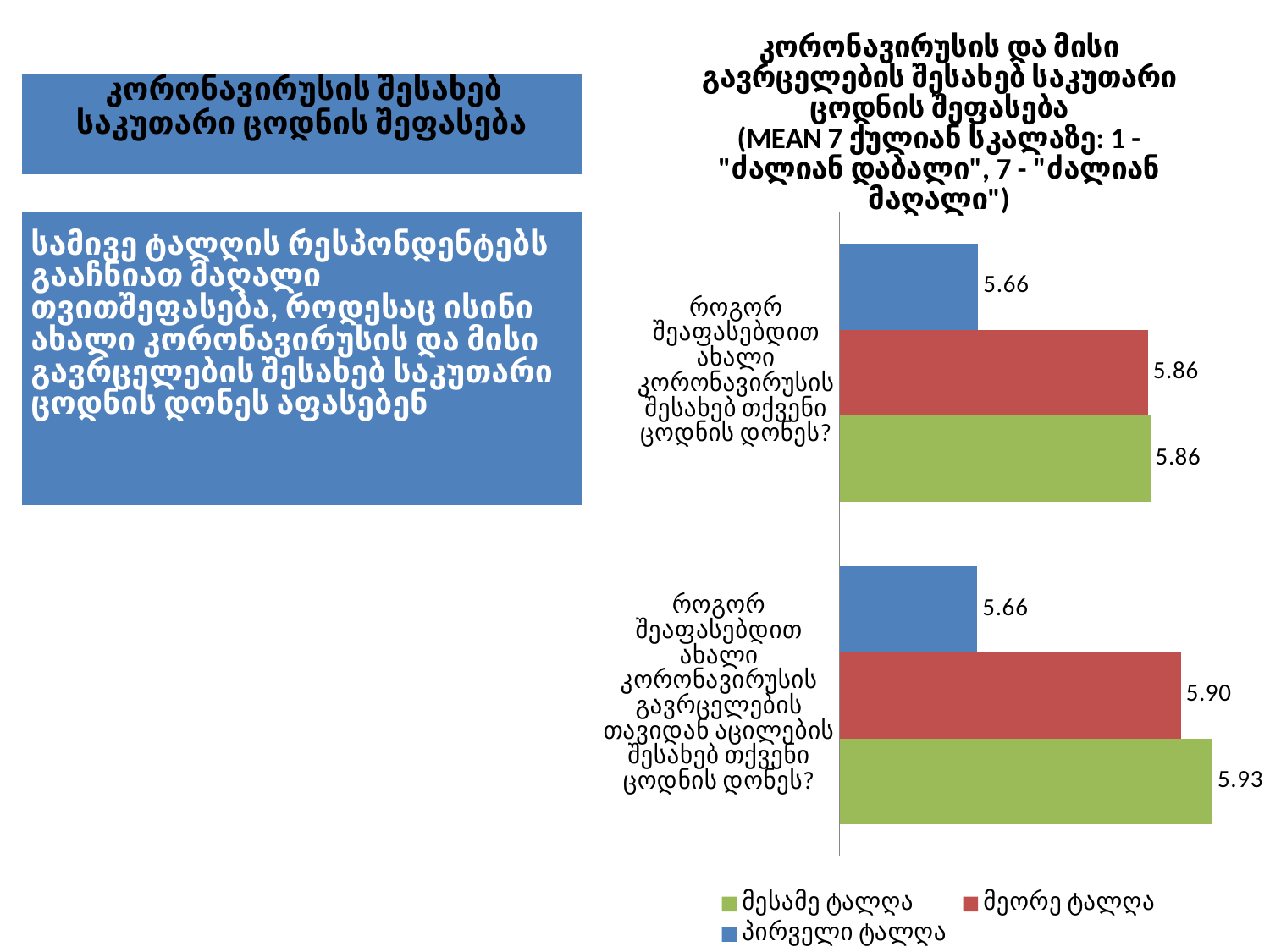
What type of chart is shown on the slide? bar chart How many categories (questions) are plotted on the chart? 2 How many series does the legend list? 3 Which series has the highest value for the question about knowledge of preventing the spread of the coronavirus? მესამე ტალღა What is the difference between the მესამე ტალღა and პირველი ტალღა values for the question about knowledge of preventing the spread of the coronavirus? 0.27 What is the value for მესამე ტალღა for the question about knowledge of preventing the spread of the coronavirus (როგორ შეაფასებდით ახალი კორონავირუსის გავრცელების თავიდან აცილების შესახებ თქვენი ცოდნის დონეს?)? 5.93 Which is larger: the მეორე ტალღა value for the question about knowledge of the new coronavirus, or the მეორე ტალღა value for the question about preventing its spread? the question about preventing its spread (5.90) What is the value for პირველი ტალღა for the question about knowledge of the new coronavirus (როგორ შეაფასებდით ახალი კორონავირუსის შესახებ თქვენი ცოდნის დონეს?)? 5.66 What is the value for მეორე ტალღა for the question about knowledge of preventing the spread of the coronavirus? 5.90 What is the value for მეორე ტალღა for the question about knowledge of the new coronavirus (როგორ შეაფასებდით ახალი კორონავირუსის შესახებ თქვენი ცოდნის დონეს?)? 5.86 Which series has the lowest value for the question about knowledge of the new coronavirus? პირველი ტალღა Which colour represents მესამე ტალღა in the chart? green